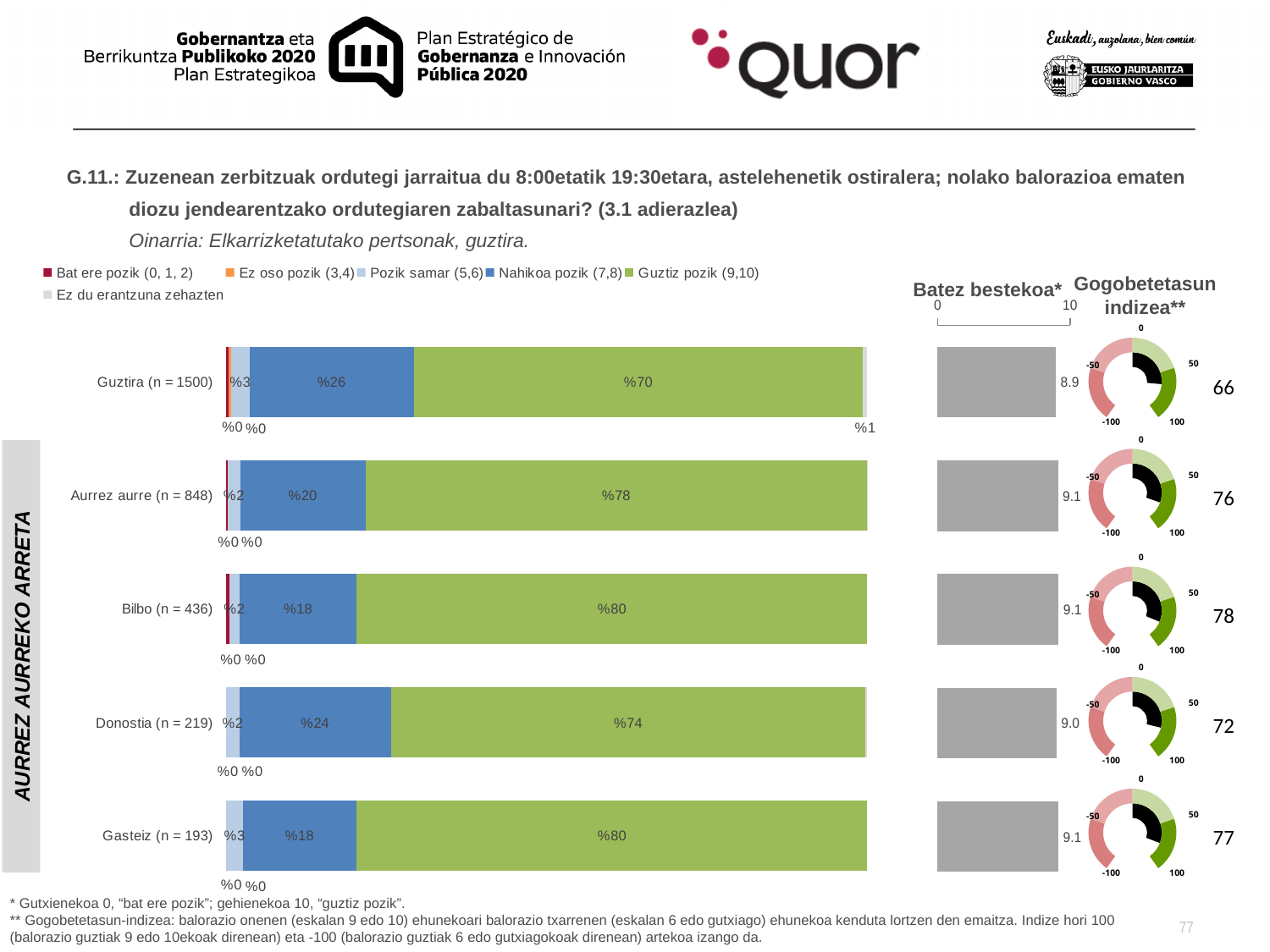
In the stacked bar chart, is the "Nahikoa pozik (7,8)" value larger for Guztira (n = 1500) or for Bilbo (n = 436)? Guztira (n = 1500) In the stacked bar chart, which category has the lowest "Guztiz pozik (9,10)" share? Guztira (n = 1500) In the stacked bar chart, what percentage of Guztira (n = 1500) respondents answered "Guztiz pozik (9,10)"? %70 How many categories (rows) does the stacked bar chart show? 5 In the stacked bar chart, which category has the highest "Guztiz pozik (9,10)" share? Bilbo (n = 436) and Gasteiz (n = 193), both %80 What kind of chart is the main chart on the slide? Stacked bar chart In the stacked bar chart, what is the difference between the "Guztiz pozik (9,10)" values for Aurrez aurre (n = 848) and Guztira (n = 1500)? 8 percentage points In the stacked bar chart, what is the "Nahikoa pozik (7,8)" value for Donostia (n = 219)? %24 In the "Batez bestekoa*" chart, what is the average score for Guztira (n = 1500)? 8.9 In the "Gogobetetasun indizea**" gauges, which category has the lowest index value? Guztira (n = 1500) How many series does the legend of the stacked bar chart list? 6 In the "Gogobetetasun indizea**" gauges, what is the index value for Bilbo (n = 436)? 78